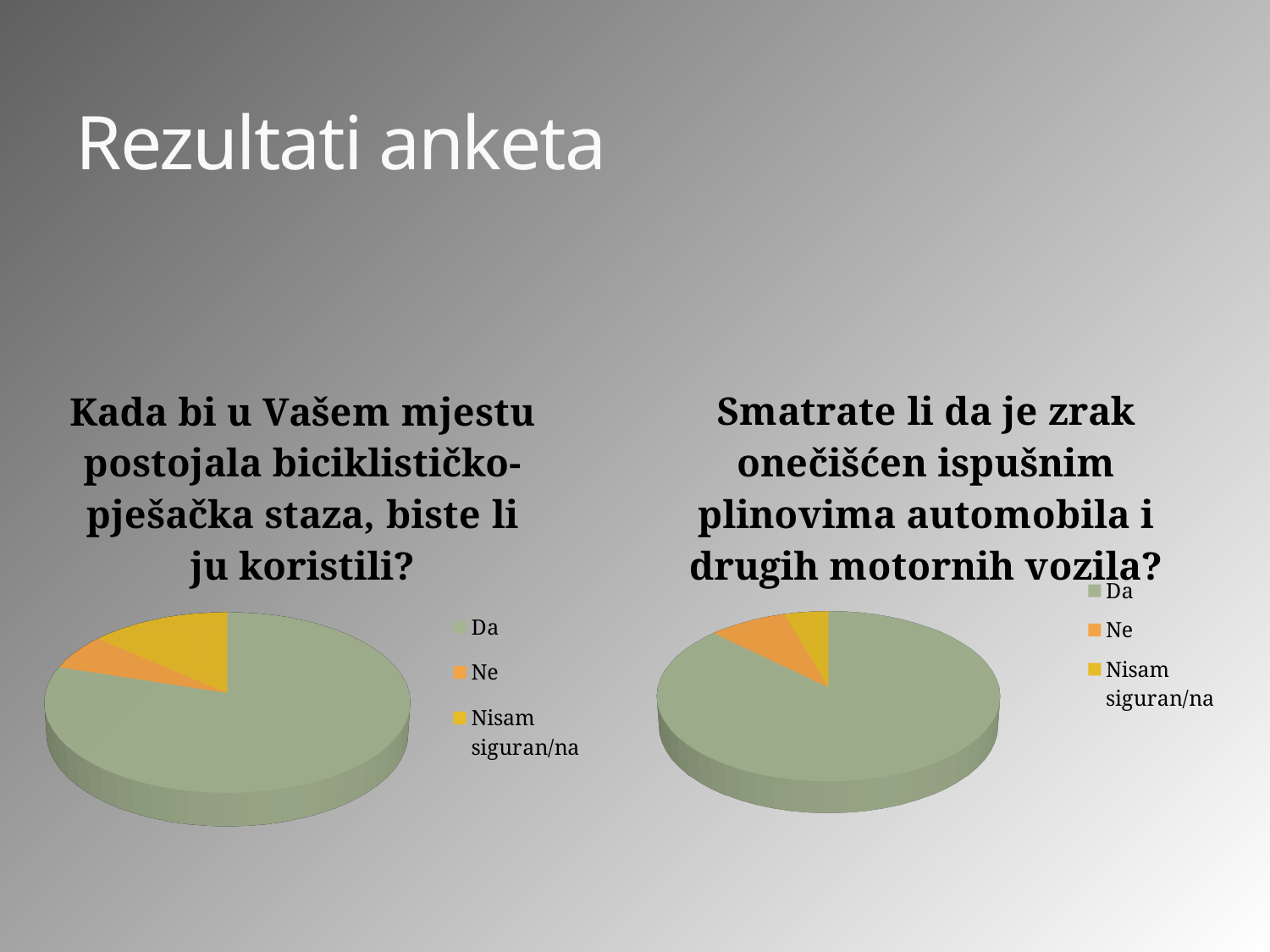
In the right chart (zrak onečišćen), which category has the largest slice? Da In the right chart (zrak onečišćen), which slice is larger: Ne or Nisam siguran/na? Ne In the left chart (biciklističko-pješačka staza), which slice is larger: Ne or Nisam siguran/na? Nisam siguran/na How many categories does the legend of the left chart (biciklističko-pješačka staza) list? 3 What kind of chart is the left chart, titled "Kada bi u Vašem mjestu postojala biciklističko-pješačka staza, biste li ju koristili?"? Pie chart What is the title of the slide containing the two pie charts? Rezultati anketa In the right chart (zrak onečišćen), which category has the smallest slice? Nisam siguran/na In the right chart (zrak onečišćen), what colour is the slice for Ne? Orange In the left chart (biciklističko-pješačka staza), which category has the smallest slice? Ne How many slices does the right chart (zrak onečišćen) have? 3 What kind of chart is the right chart, titled "Smatrate li da je zrak onečišćen ispušnim plinovima automobila i drugih motornih vozila?"? Pie chart In the left chart (biciklističko-pješačka staza), which category has the largest slice? Da